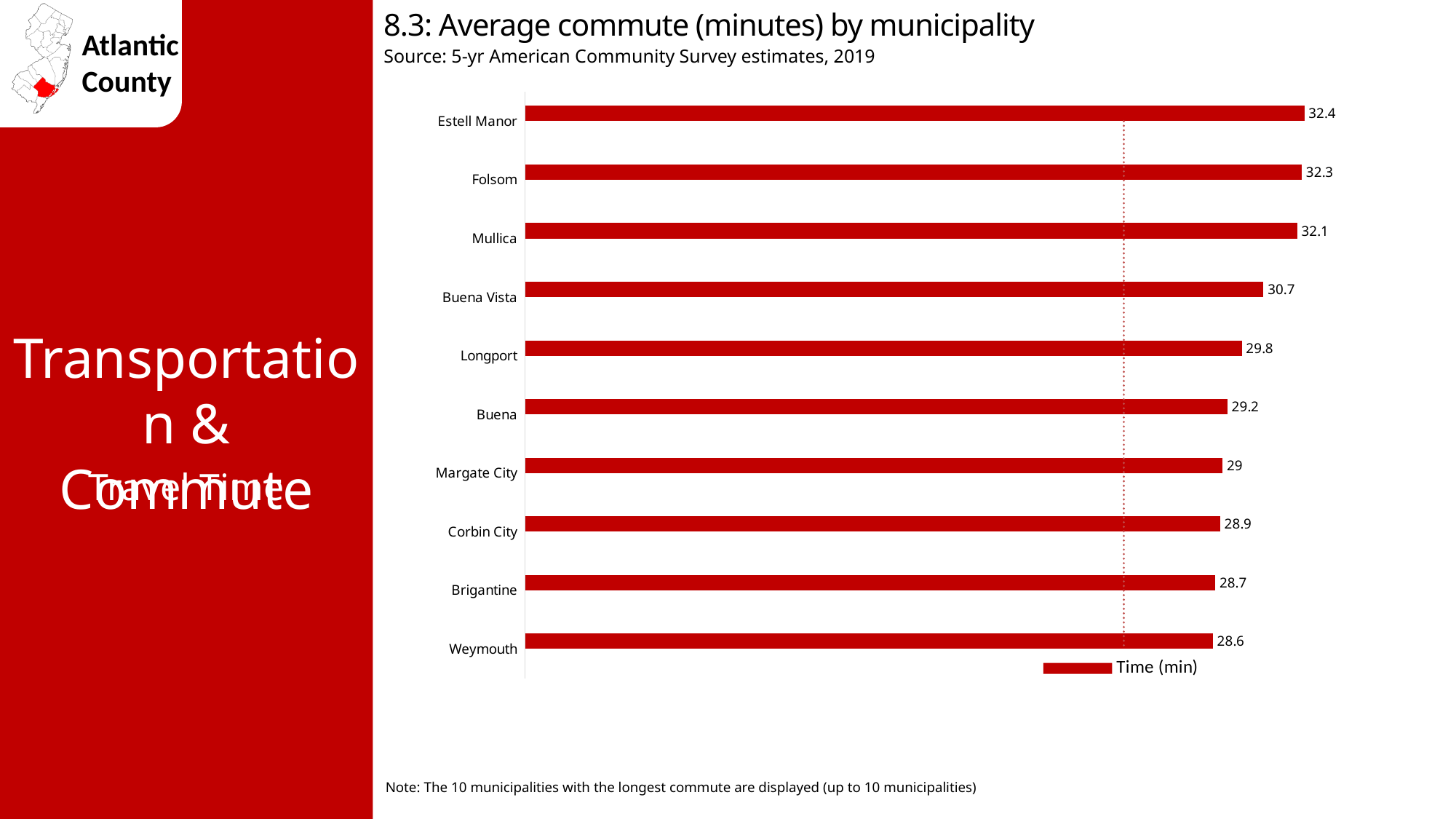
Which municipality has the shortest average commute among those shown? Weymouth What is the average commute time for Estell Manor? 32.4 Which municipality has the longest average commute? Estell Manor What is the difference in average commute time between Estell Manor and Weymouth? 3.8 What is the average commute time for Buena Vista? 30.7 What is the difference in average commute time between Mullica and Longport? 2.3 What is the average commute time for Weymouth? 28.6 What is the legend entry for the series in the chart? Time (min) How many municipalities are shown in the chart? 10 Which has a longer average commute, Buena Vista or Brigantine? Buena Vista What kind of chart is used to show average commute by municipality? Bar chart What is the average commute time for Margate City? 29